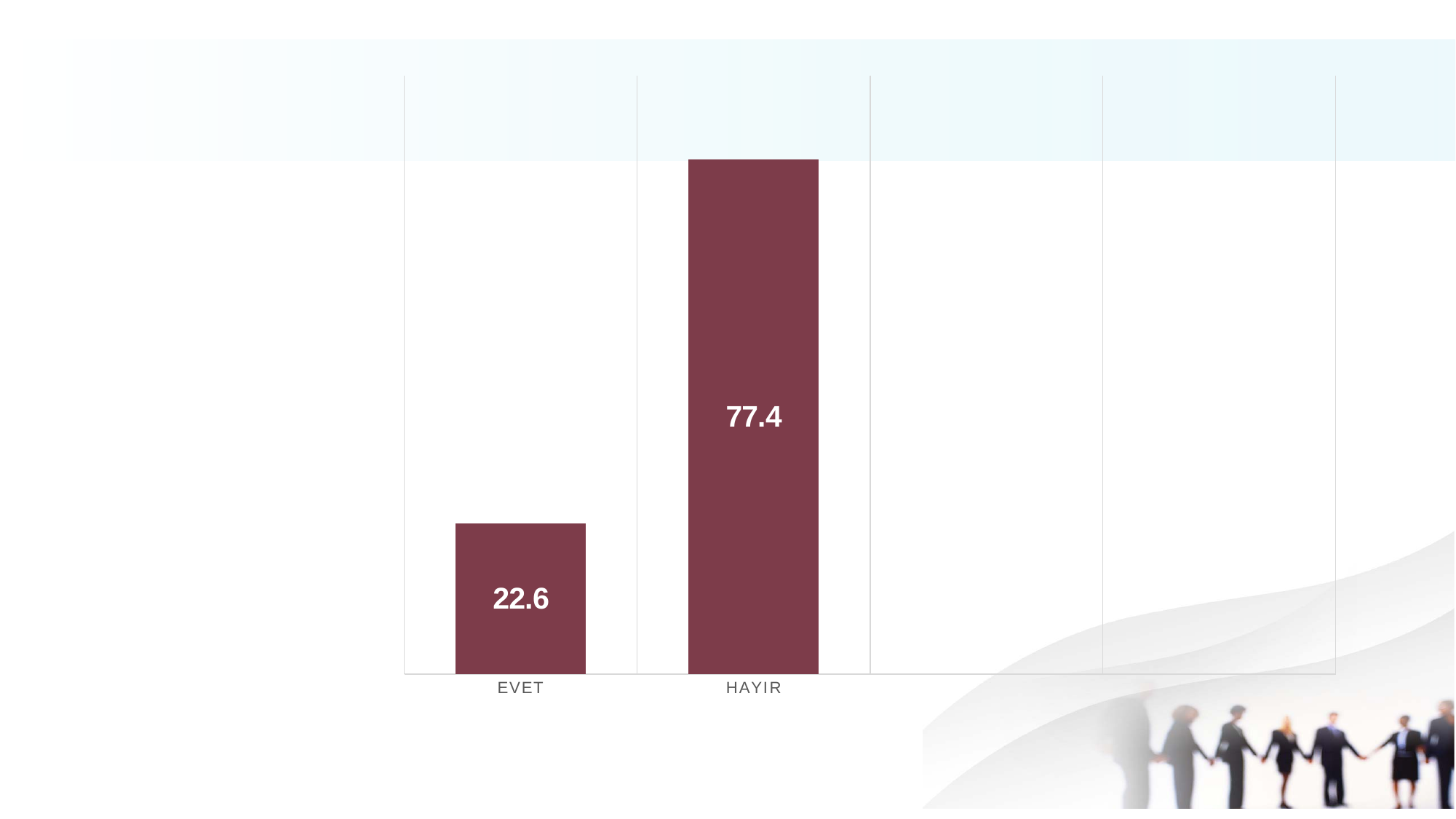
What is the difference between the values for HAYIR and EVET? 54.8 What colour are the bars in the chart? Dark red Which is larger, the value for EVET or the value for HAYIR? HAYIR What is the total of the values for EVET and HAYIR? 100 What is the value for HAYIR? 77.4 Which category has the highest value? HAYIR What kind of chart is shown on the slide? Bar chart Which category has the lowest value? EVET What is the value for EVET? 22.6 What is the label of the first category on the x axis? EVET How many categories are shown in the chart? 2